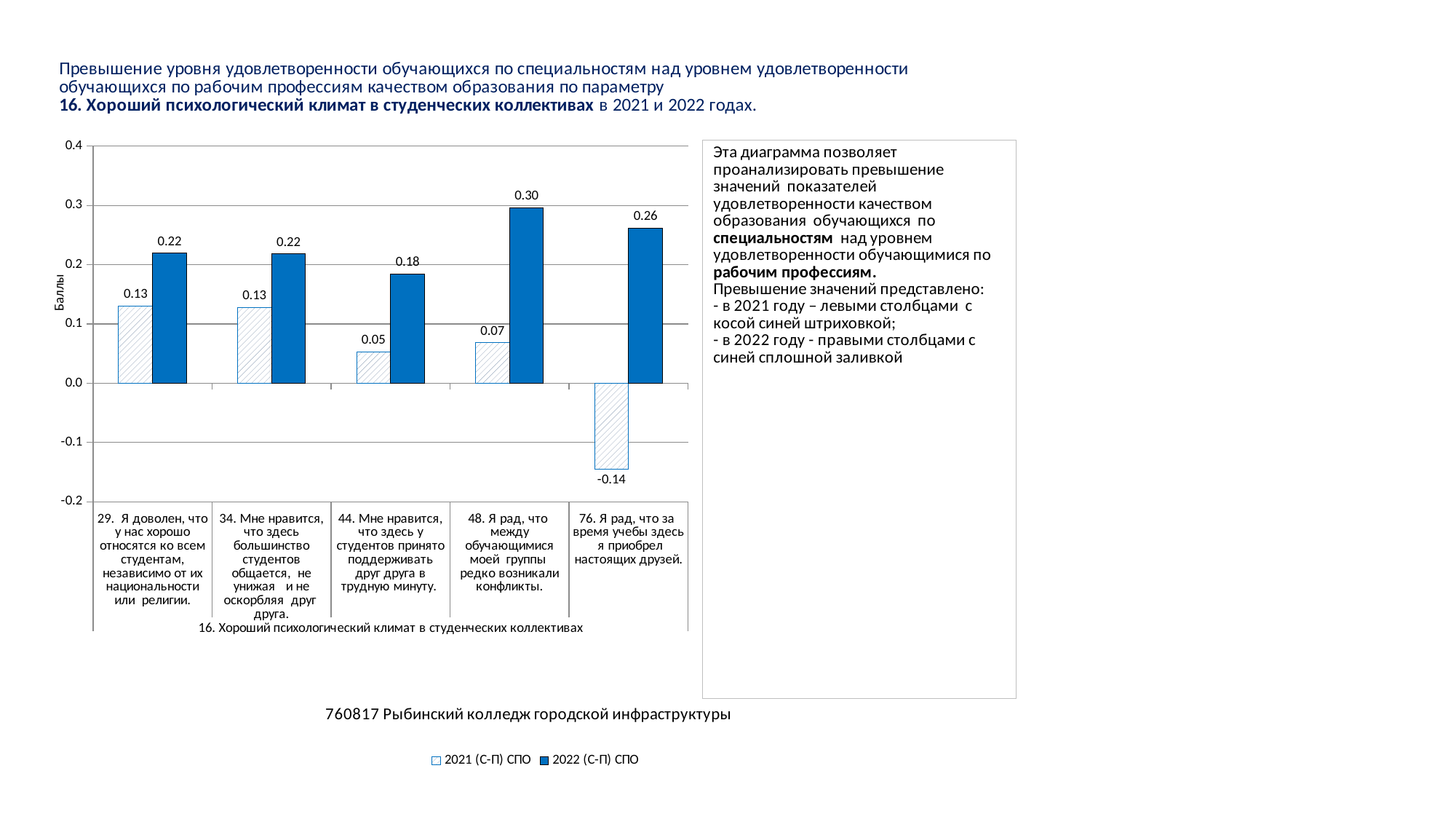
What is the difference between the 2022 and 2021 values for category 29? 0.09 What is the 2022 (С-П) СПО value for category 48 (Я рад, что между обучающимися моей группы редко возникали конфликты)? 0.30 For category 76, which series has the larger value: 2021 (С-П) СПО or 2022 (С-П) СПО? 2022 (С-П) СПО Which category has the lowest 2021 (С-П) СПО value? 76. Я рад, что за время учебы здесь я приобрел настоящих друзей. What kind of chart is shown on the slide? Bar chart What is the 2021 (С-П) СПО value for category 76 (Я рад, что за время учебы здесь я приобрел настоящих друзей)? -0.14 What is the label of the vertical axis of the chart? Баллы Which category has the highest 2022 (С-П) СПО value? 48. Я рад, что между обучающимися моей группы редко возникали конфликты. How many series does the legend list? 2 What is the difference between the 2022 and 2021 values for category 48? 0.23 What is the 2021 (С-П) СПО value for category 44 (Мне нравится, что здесь у студентов принято поддерживать друг друга в трудную минуту)? 0.05 How many categories are shown on the x axis of the chart? 5